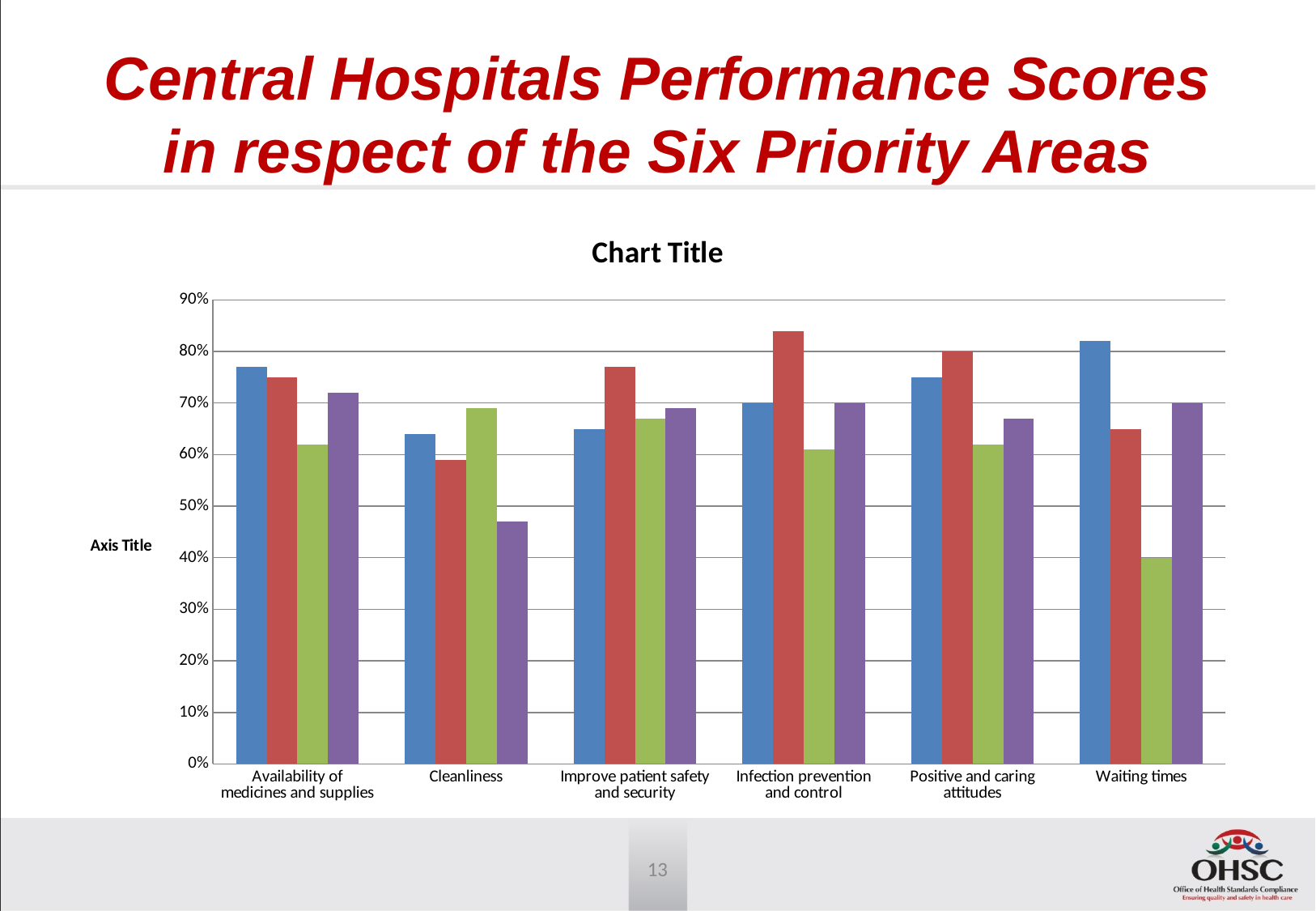
Is the value of the red bar for Infection prevention and control greater or less than 80%? greater For Cleanliness, which bar is taller, the green bar or the purple bar? green Is the value of the blue bar for Waiting times greater or less than 80%? greater How many priority area categories are shown on the x axis of the chart? 6 What kind of chart is shown on the slide? bar chart Which category has the lowest green bar in the chart? Waiting times Which category has the highest blue bar in the chart? Waiting times Is the value of the green bar for Waiting times greater or less than 50%? less What is the title printed above the chart? Chart Title How many bars are plotted for each category in the chart? 4 What label is printed on the vertical axis of the chart? Axis Title